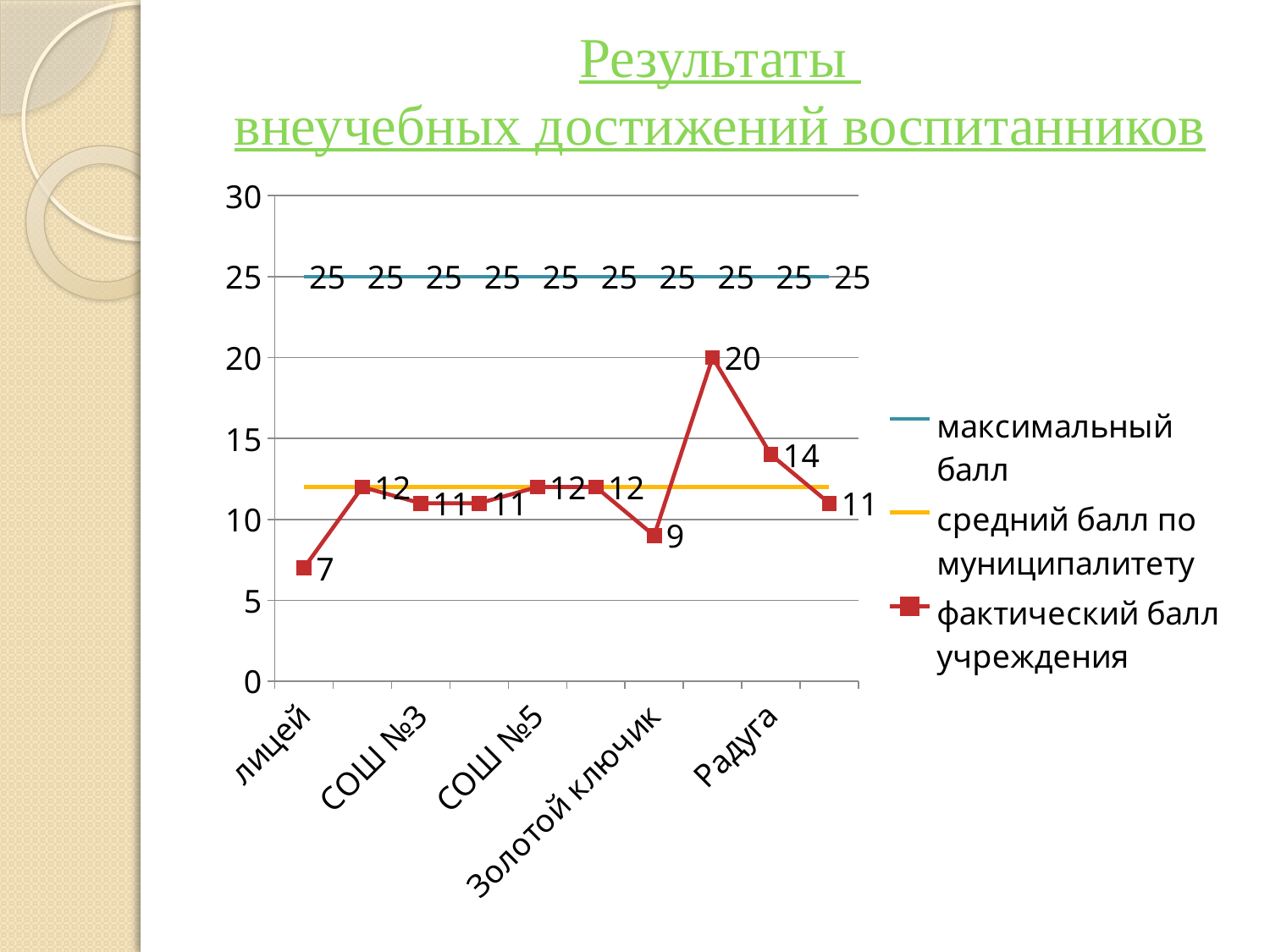
Which category has the lowest фактический балл учреждения? лицей How many series does the legend list? 3 What is the difference between the фактический балл учреждения for Радуга and for Золотой ключик? 5 What is the фактический балл учреждения for Радуга? 14 What is the максимальный балл value shown for лицей? 25 What is the highest value of the фактический балл учреждения series? 20 Which has a higher фактический балл учреждения, СОШ №3 or СОШ №5? СОШ №5 What is the фактический балл учреждения for лицей? 7 How many data points does the фактический балл учреждения series have? 10 What is the фактический балл учреждения for Золотой ключик? 9 What kind of chart is shown on the slide? line chart Is the средний балл по муниципалитету line greater or less than 10? greater